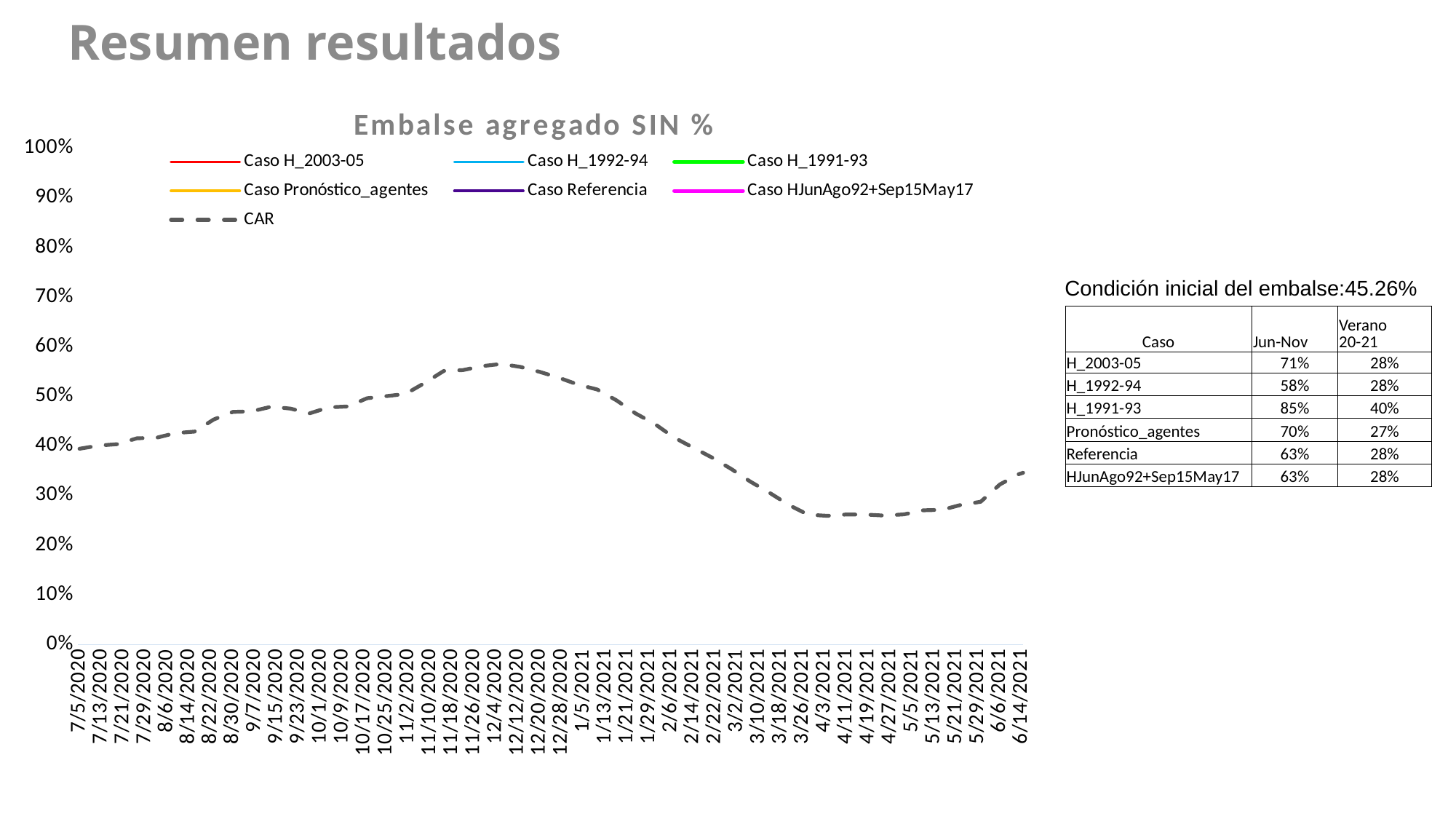
What is the title of the chart on the slide? Embalse agregado SIN % In the 'Embalse agregado SIN %' chart, does the CAR series rise or fall between 12/4/2020 and 4/3/2021? fall What kind of chart is 'Embalse agregado SIN %'? line chart In the 'Embalse agregado SIN %' chart, is the CAR value at 4/11/2021 greater or less than 30%? less In the 'Embalse agregado SIN %' chart, does the CAR series rise or fall between 7/5/2020 and 11/26/2020? rise In the 'Embalse agregado SIN %' chart, how is the CAR series drawn in the legend? dashed grey line How many series does the legend of the 'Embalse agregado SIN %' chart list? 7 In the 'Embalse agregado SIN %' chart, is the highest CAR value greater or less than 60%? less In the 'Embalse agregado SIN %' chart, is the CAR value at 12/4/2020 greater or less than 50%? greater In the 'Embalse agregado SIN %' chart, in which month does the CAR series reach its lowest point? April 2021